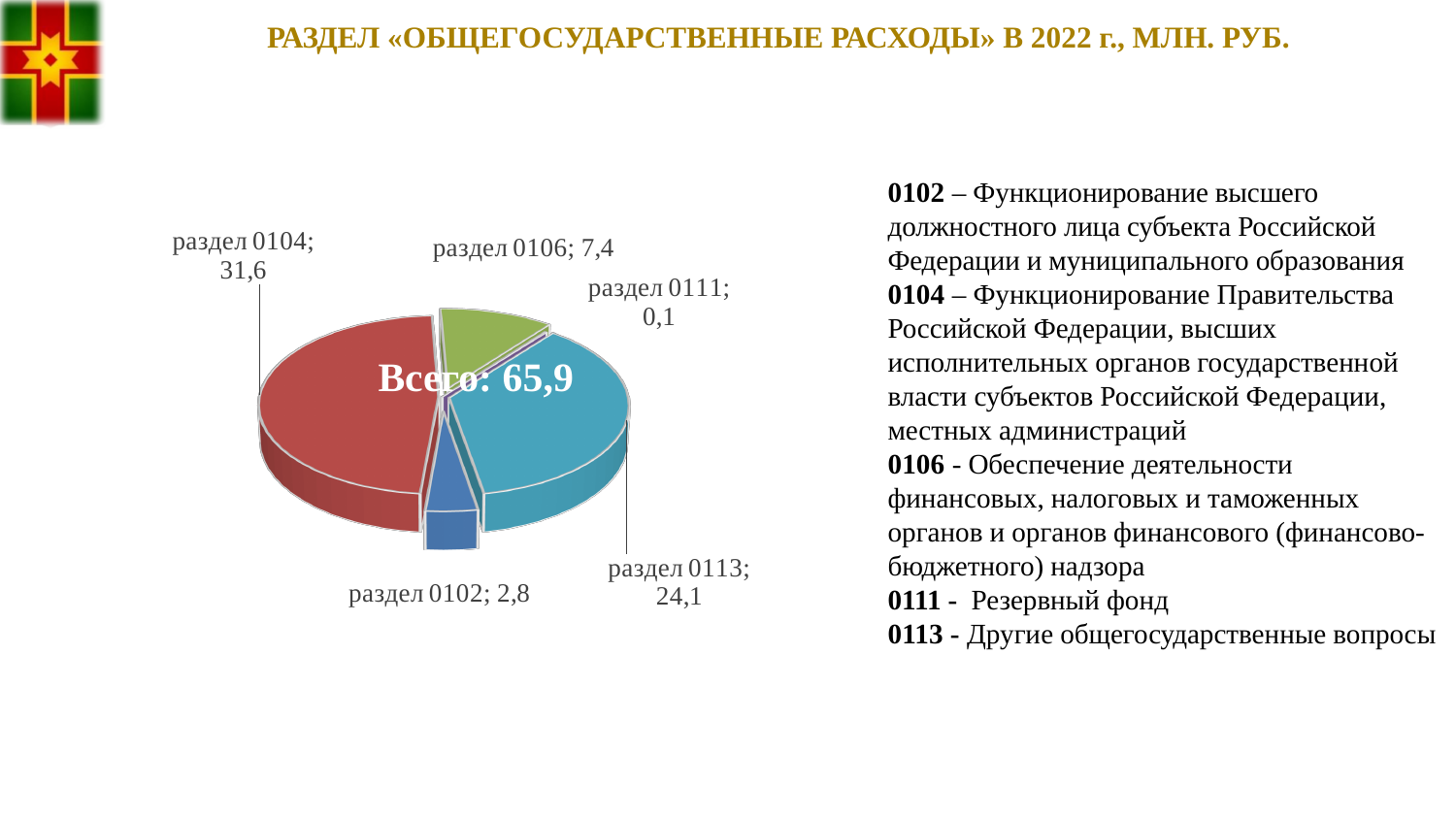
What is the value for раздел 0102? 2,8 What is the value for раздел 0106? 7,4 What is the difference between the values for раздел 0104 and раздел 0113? 7,5 What is the value for раздел 0113? 24,1 What is the value for раздел 0104? 31,6 What is the value for раздел 0111? 0,1 What is the difference between the values for раздел 0106 and раздел 0102? 4,6 What kind of chart is shown on the slide? Pie chart How many sections (slices) are shown in the pie chart? 5 Which section has the largest slice of the pie? раздел 0104 Which is larger, the value for раздел 0113 or the value for раздел 0106? раздел 0113 Which section has the smallest slice of the pie? раздел 0111